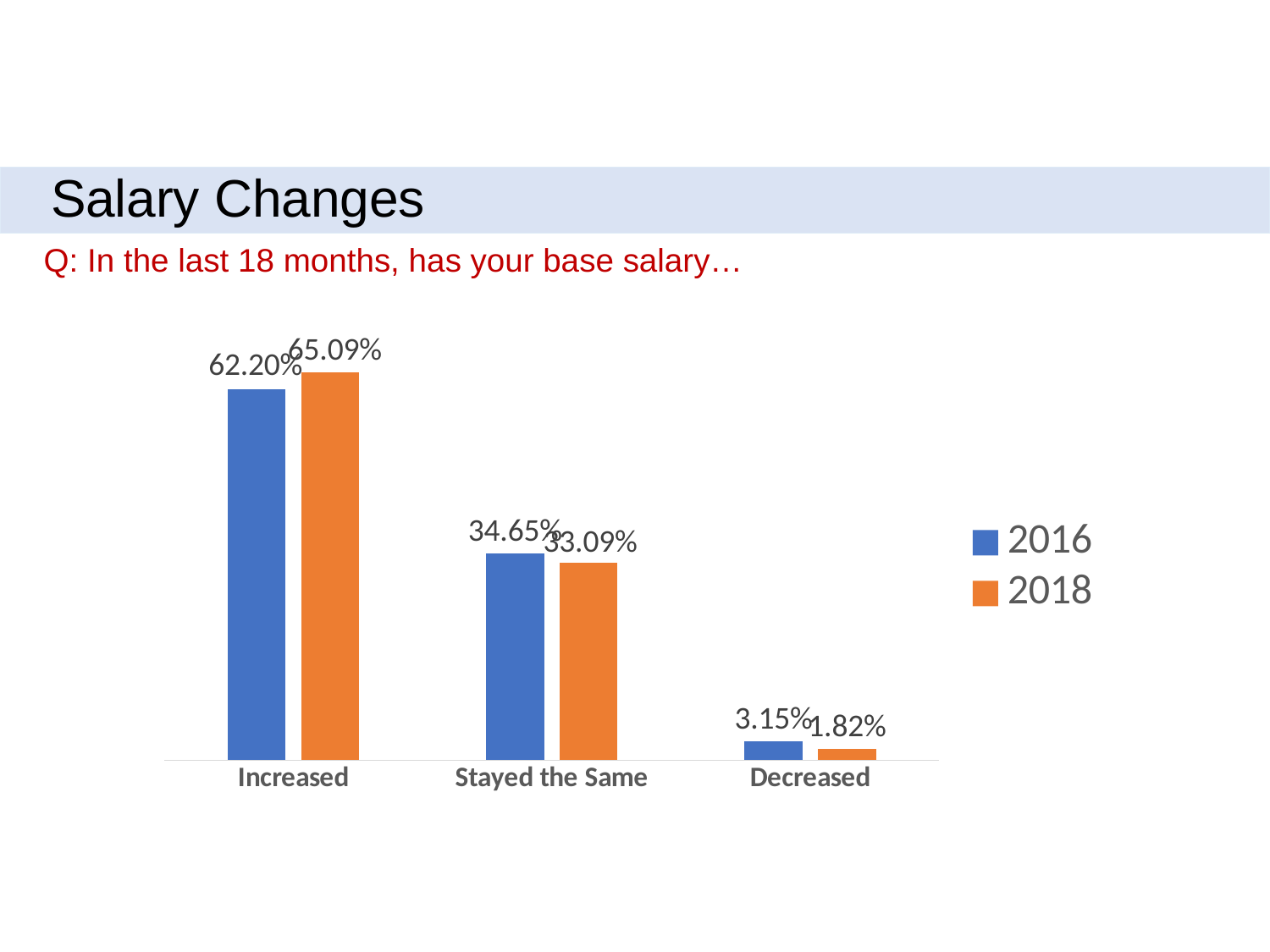
Which is larger for Stayed the Same, the 2016 value or the 2018 value? 2016 How many series does the legend list? 2 Which colour represents the 2018 series in the legend? Orange What is the 2016 value for Decreased? 3.15% Which category has the highest value for 2018? Increased What percentage of respondents said their base salary increased in 2016? 62.20% What is the 2018 value for Stayed the Same? 33.09% How many categories are shown on the x axis? 3 Which category has the lowest value for 2016? Decreased What is the difference between the 2018 and 2016 values for Increased? 2.89% What percentage of respondents said their base salary increased in 2018? 65.09% What kind of chart is shown on the slide? Bar chart